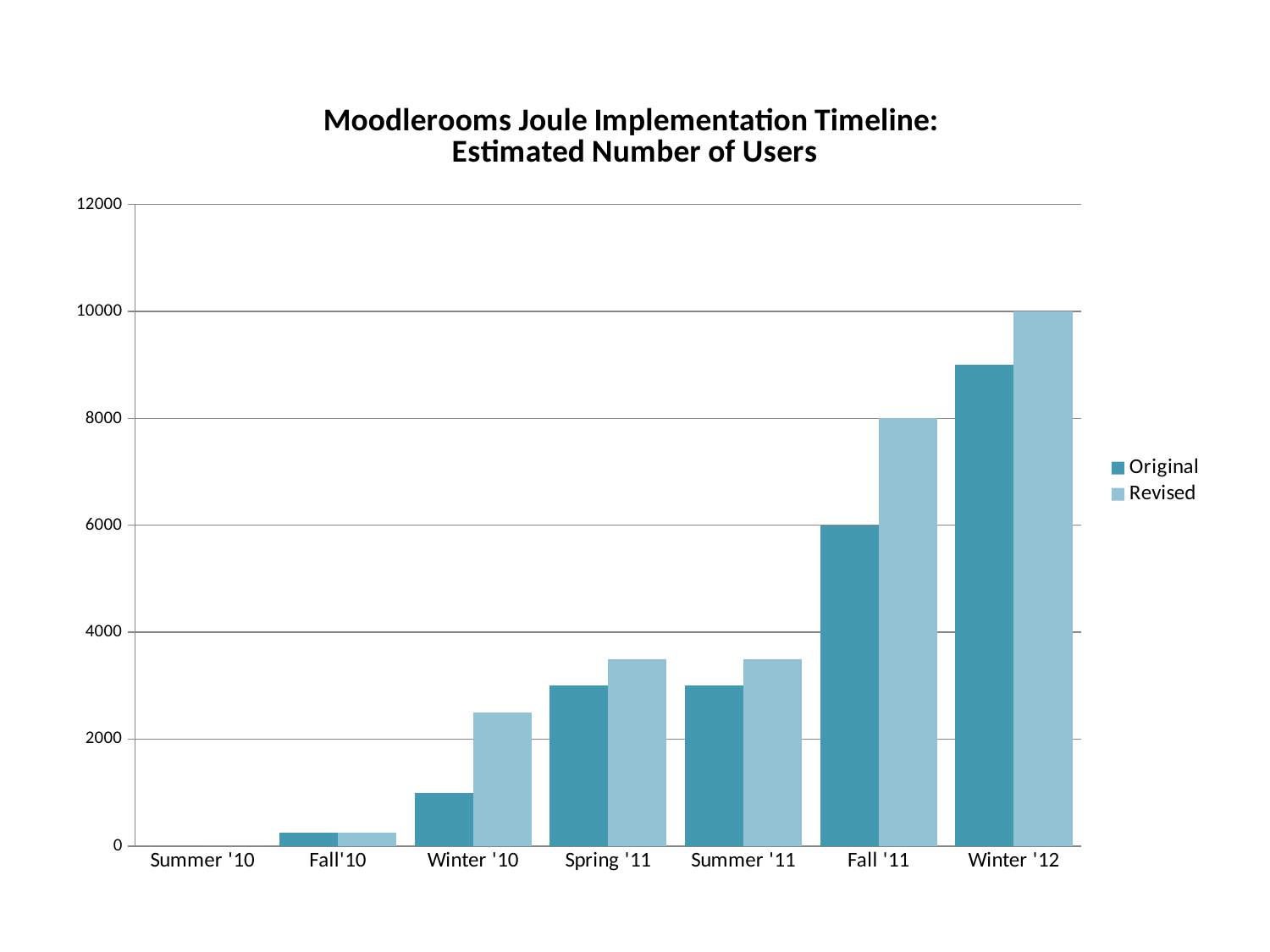
For Fall '11, which is larger, the Original or the Revised value? Revised Do the Revised values generally rise or fall from Summer '10 to Winter '12? rise Is the Original value for Winter '12 greater or less than 8000? greater Is the Revised value for Winter '10 greater or less than 2000? greater How many series does the legend list? 2 What is the Revised value for Winter '12? 10000 What is the Revised value for Fall '11? 8000 How many time periods are shown on the x axis? 7 Which period has the highest Revised value? Winter '12 What type of chart is shown on the slide? bar chart What is the Original value for Fall '11? 6000 Which period has the lowest Original value? Summer '10